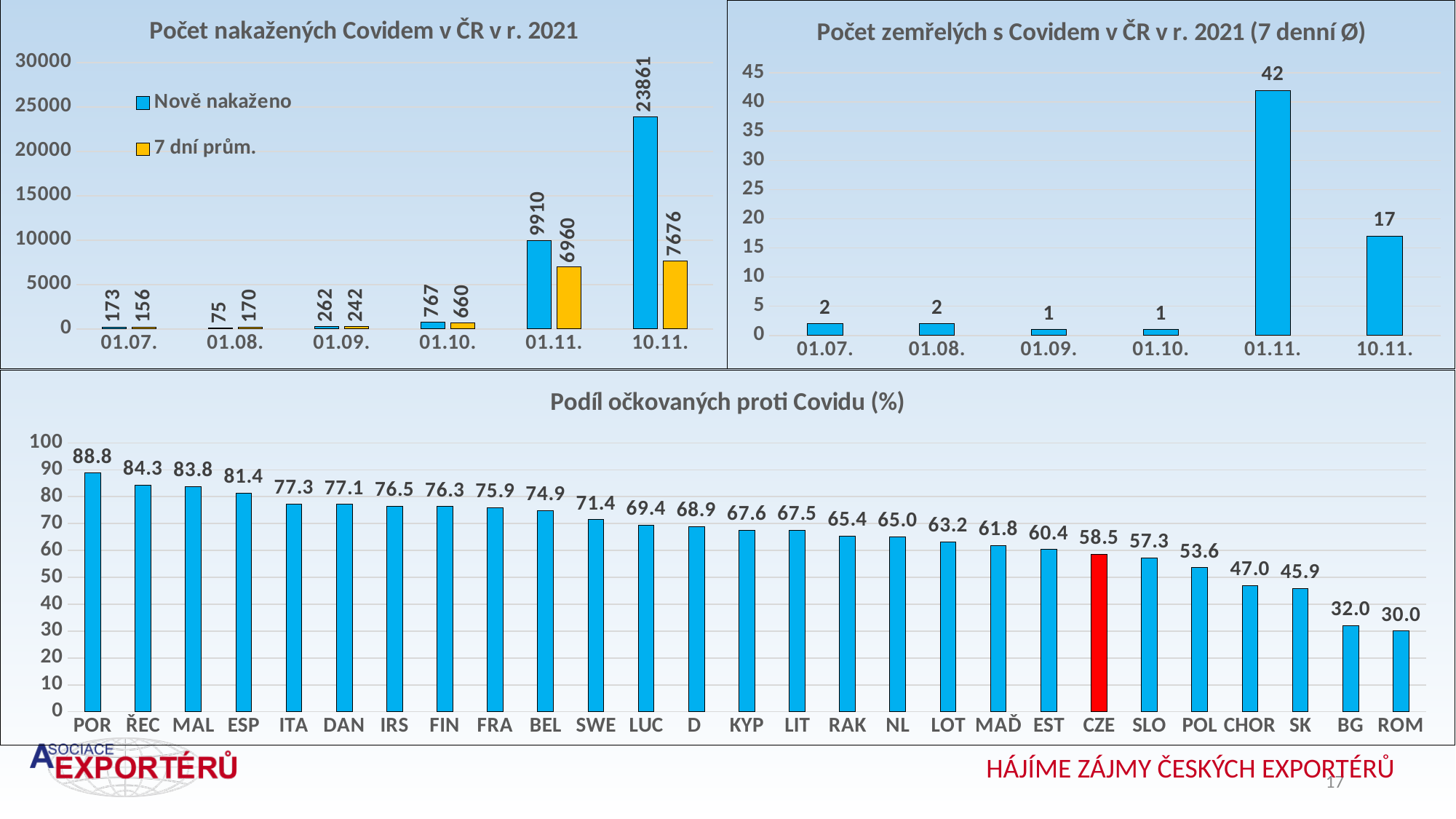
In the chart 'Podíl očkovaných proti Covidu (%)', which country has the highest value? POR In the chart 'Počet nakažených Covidem v ČR v r. 2021', what is the value of '7 dní prům.' for 01.11.? 6960 In the chart 'Počet nakažených Covidem v ČR v r. 2021', what is the value of 'Nově nakaženo' for 10.11.? 23861 In the chart 'Počet zemřelých s Covidem v ČR v r. 2021 (7 denní Ø)', what is the value for 01.11.? 42 In the chart 'Počet zemřelých s Covidem v ČR v r. 2021 (7 denní Ø)', what is the difference between the values for 01.11. and 10.11.? 25 In the chart 'Počet nakažených Covidem v ČR v r. 2021', which date has the lowest 'Nově nakaženo' value? 01.08. In the chart 'Podíl očkovaných proti Covidu (%)', how many countries are shown? 27 In the chart 'Počet nakažených Covidem v ČR v r. 2021', what is the difference between 'Nově nakaženo' and '7 dní prům.' on 10.11.? 16185 In the chart 'Podíl očkovaných proti Covidu (%)', which bar is coloured red? CZE In the chart 'Počet nakažených Covidem v ČR v r. 2021', how many series does the legend list? 2 In the chart 'Počet zemřelých s Covidem v ČR v r. 2021 (7 denní Ø)', how many dates are shown on the x axis? 6 In the chart 'Podíl očkovaných proti Covidu (%)', what is the value for CZE? 58.5